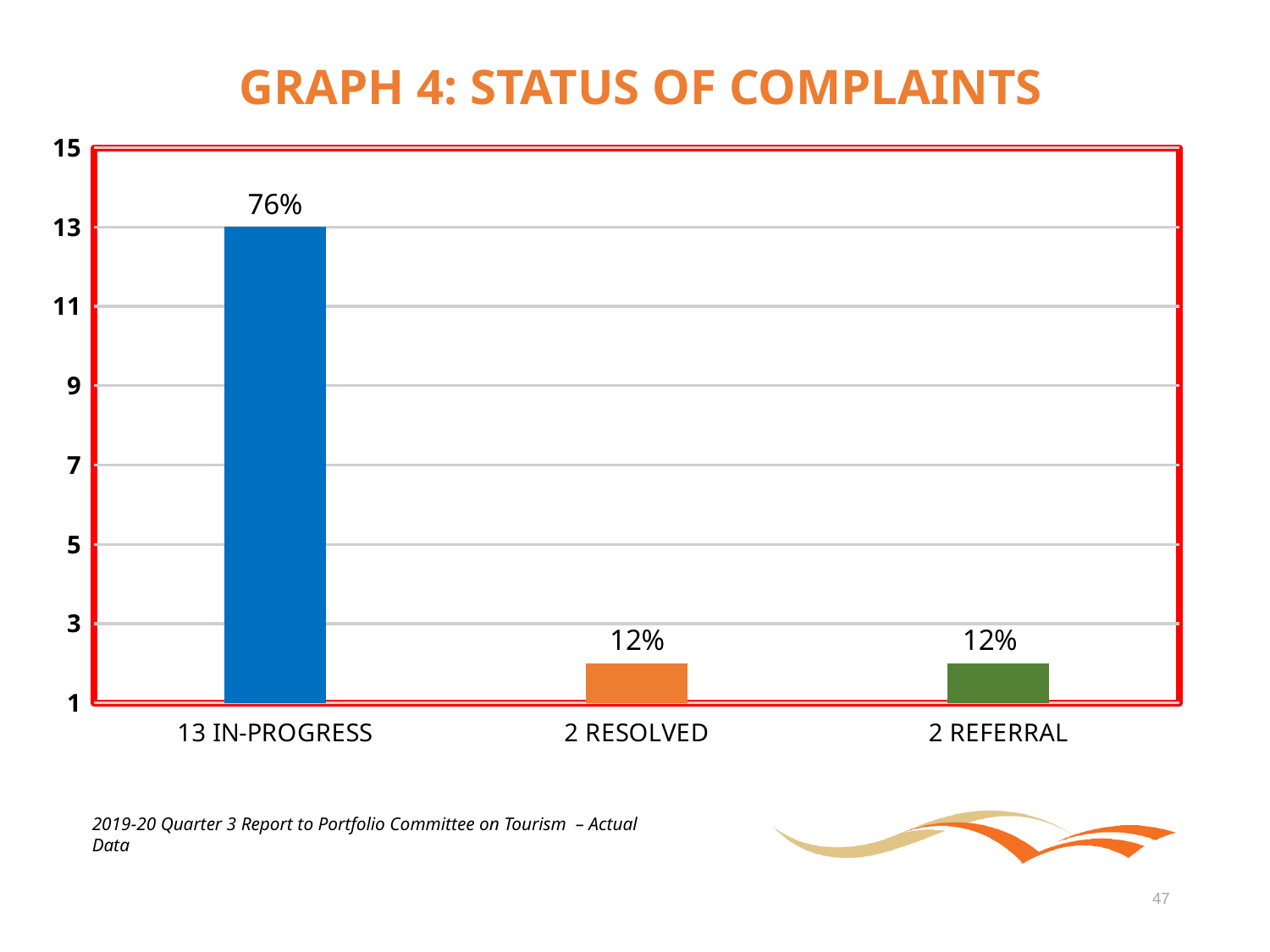
What data label is shown on the bar for 2 RESOLVED? 12% Which is larger, the bar for 13 IN-PROGRESS or the bar for 2 REFERRAL? 13 IN-PROGRESS What colour is the bar for 2 RESOLVED? Orange Is the bar for 2 RESOLVED greater or less than 5 on the vertical axis? less Is the bar for 13 IN-PROGRESS greater or less than 11 on the vertical axis? greater How many categories are shown on the chart? 3 What data label is shown on the bar for 2 REFERRAL? 12% What kind of chart is shown on the slide? Bar chart Which category has the highest bar? 13 IN-PROGRESS What data label is shown on the bar for 13 IN-PROGRESS? 76% What is the title of the chart? GRAPH 4: STATUS OF COMPLAINTS What is the difference between the percentage labels for 13 IN-PROGRESS and 2 RESOLVED? 64%